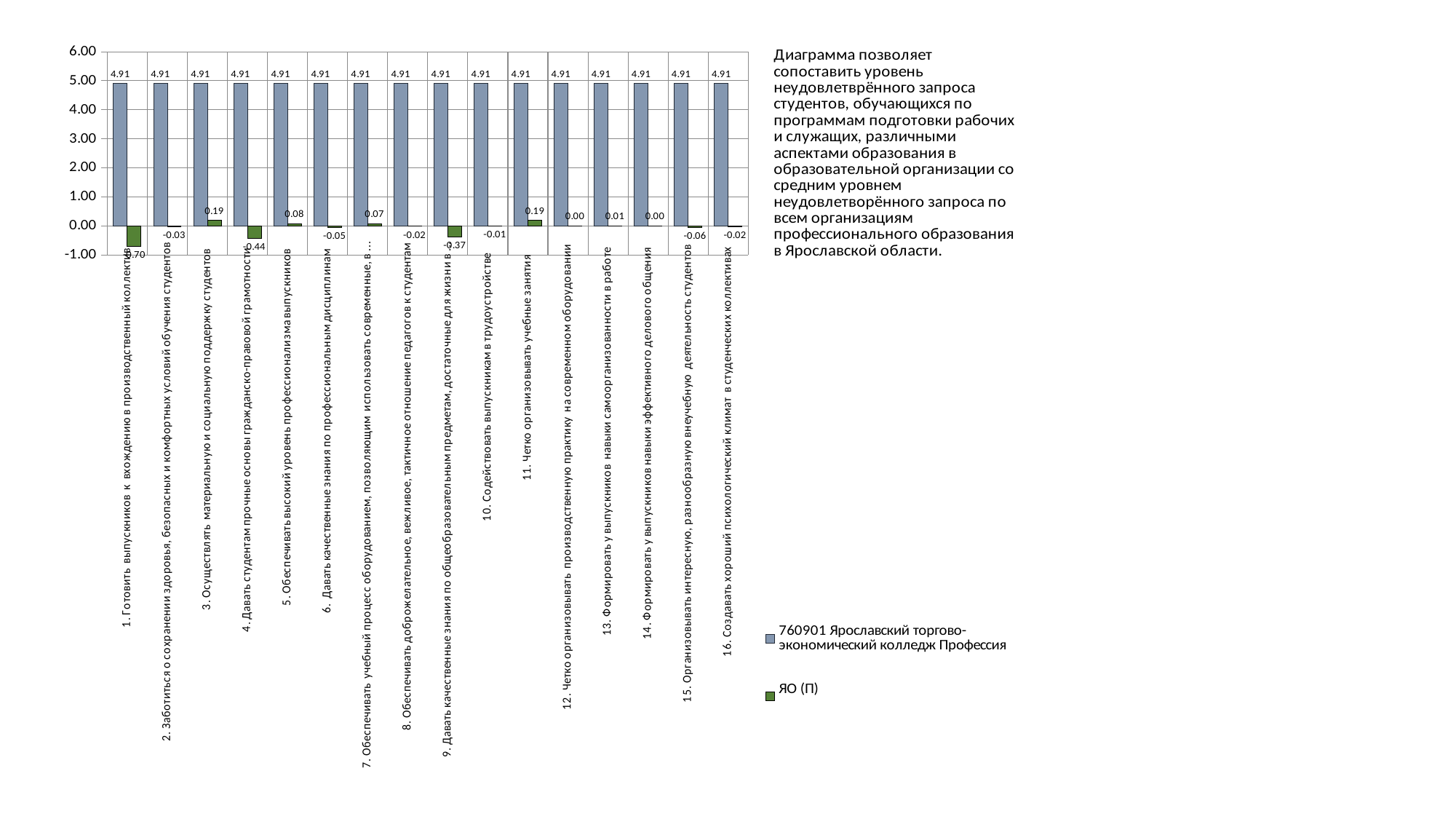
Which category has the lowest value for the series 'ЯО (П)'? 1. Готовить выпускников к вхождению в производственный коллектив What is the value of the series 'ЯО (П)' for category '9. Давать качественные знания по общеобразовательным предметам, достаточные для жизни в ...'? -0.37 Which is larger for the series 'ЯО (П)': the value for category '4. Давать студентам прочные основы гражданско-правовой грамотности' or the value for category '7. Обеспечивать учебный процесс оборудованием, позволяющим использовать современные, в...'? 7. Обеспечивать учебный процесс оборудованием, позволяющим использовать современные, в... What is the value of the series 'ЯО (П)' for category '11. Четко организовывать учебные занятия'? 0.19 What is the value of the series '760901 Ярославский торгово-экономический колледж Профессия' for category '5. Обеспечивать высокий уровень профессионализма выпускников'? 4.91 Is the value of the series '760901 Ярославский торгово-экономический колледж Профессия' for category '10. Содействовать выпускникам в трудоустройстве' greater or less than 4.00? greater What kind of chart is shown on the slide? bar chart What is the difference between the 'ЯО (П)' values for category '3. Осуществлять материальную и социальную поддержку студентов' and category '5. Обеспечивать высокий уровень профессионализма выпускников'? 0.11 How many series does the legend list? 2 What colour are the bars for the series 'ЯО (П)'? green How many categories are plotted along the x axis? 16 What is the value of the series 'ЯО (П)' for category '15. Организовывать интересную, разнообразную внеучебную деятельность студентов'? -0.06